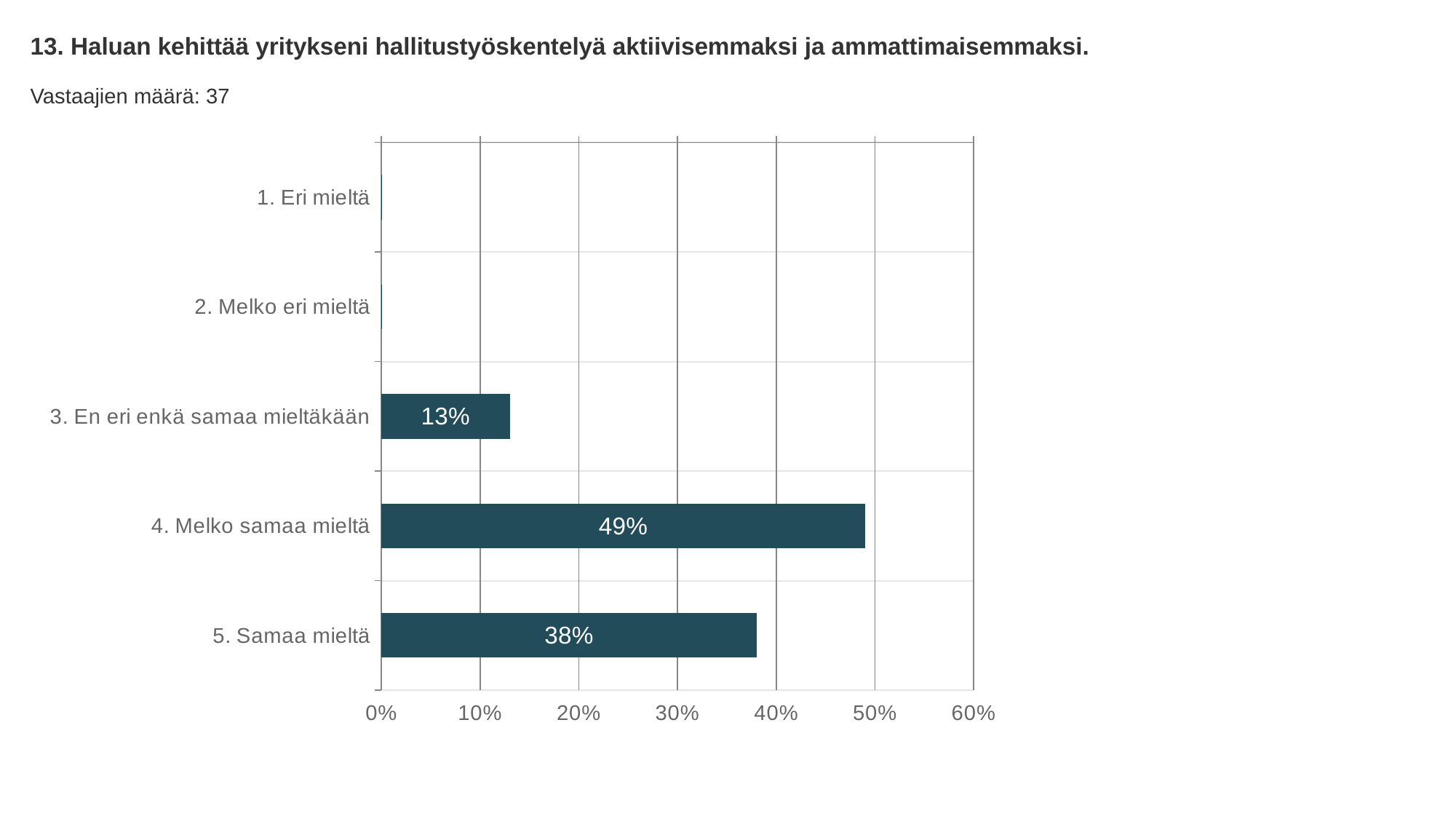
How many categories are shown on the chart? 5 What kind of chart is shown on the slide? Bar chart What is the difference between the values for "4. Melko samaa mieltä" and "5. Samaa mieltä"? 11% What is the difference between the values for "5. Samaa mieltä" and "3. En eri enkä samaa mieltäkään"? 25% How many respondents (Vastaajien määrä) are reported on the slide? 37 Which is larger, the value for "5. Samaa mieltä" or the value for "3. En eri enkä samaa mieltäkään"? 5. Samaa mieltä Which category has the highest value? 4. Melko samaa mieltä Is the value for "3. En eri enkä samaa mieltäkään" greater or less than 20%? less Is the value for "4. Melko samaa mieltä" greater or less than 40%? greater What is the value for "3. En eri enkä samaa mieltäkään"? 13% What is the value for "4. Melko samaa mieltä"? 49% What is the value for "5. Samaa mieltä"? 38%